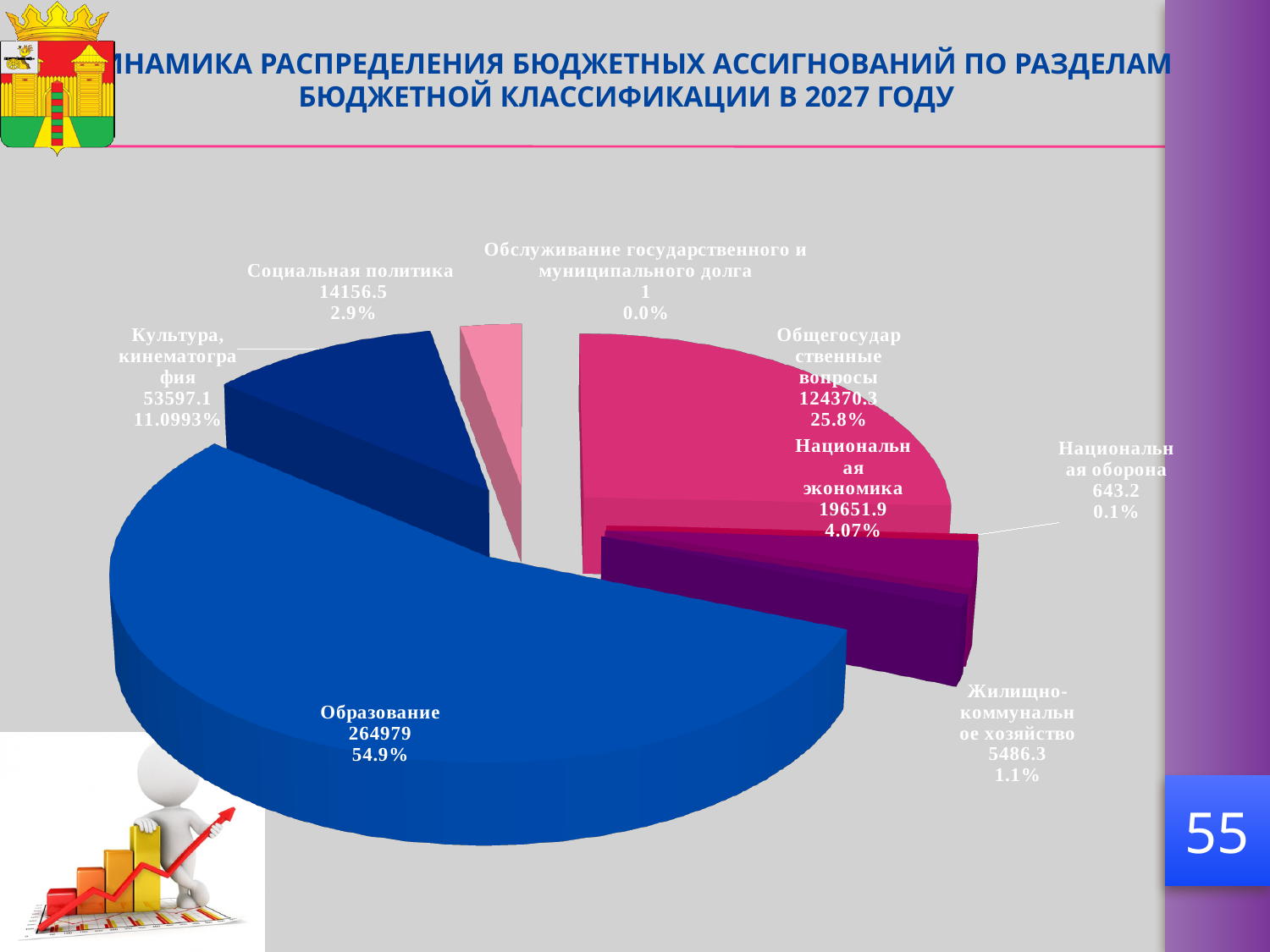
What is the value shown for Жилищно-коммунальное хозяйство? 5486.3 What share of the pie does Общегосударственные вопросы represent? 25.8% What is the difference between the values for Социальная политика and Жилищно-коммунальное хозяйство? 8670.2 What share of the pie does Культура, кинематография represent? 11.0993% What share of the pie does Образование represent? 54.9% How many categories (slices) does the pie chart show? 8 What is the value shown for Социальная политика? 14156.5 Which is larger: the value for Национальная экономика or the value for Национальная оборона? Национальная экономика Which category has the largest share of the pie? Образование What is the value shown for Образование? 264979 What kind of chart is shown on the slide? Pie chart Which category has the smallest value in the pie chart? Обслуживание государственного и муниципального долга